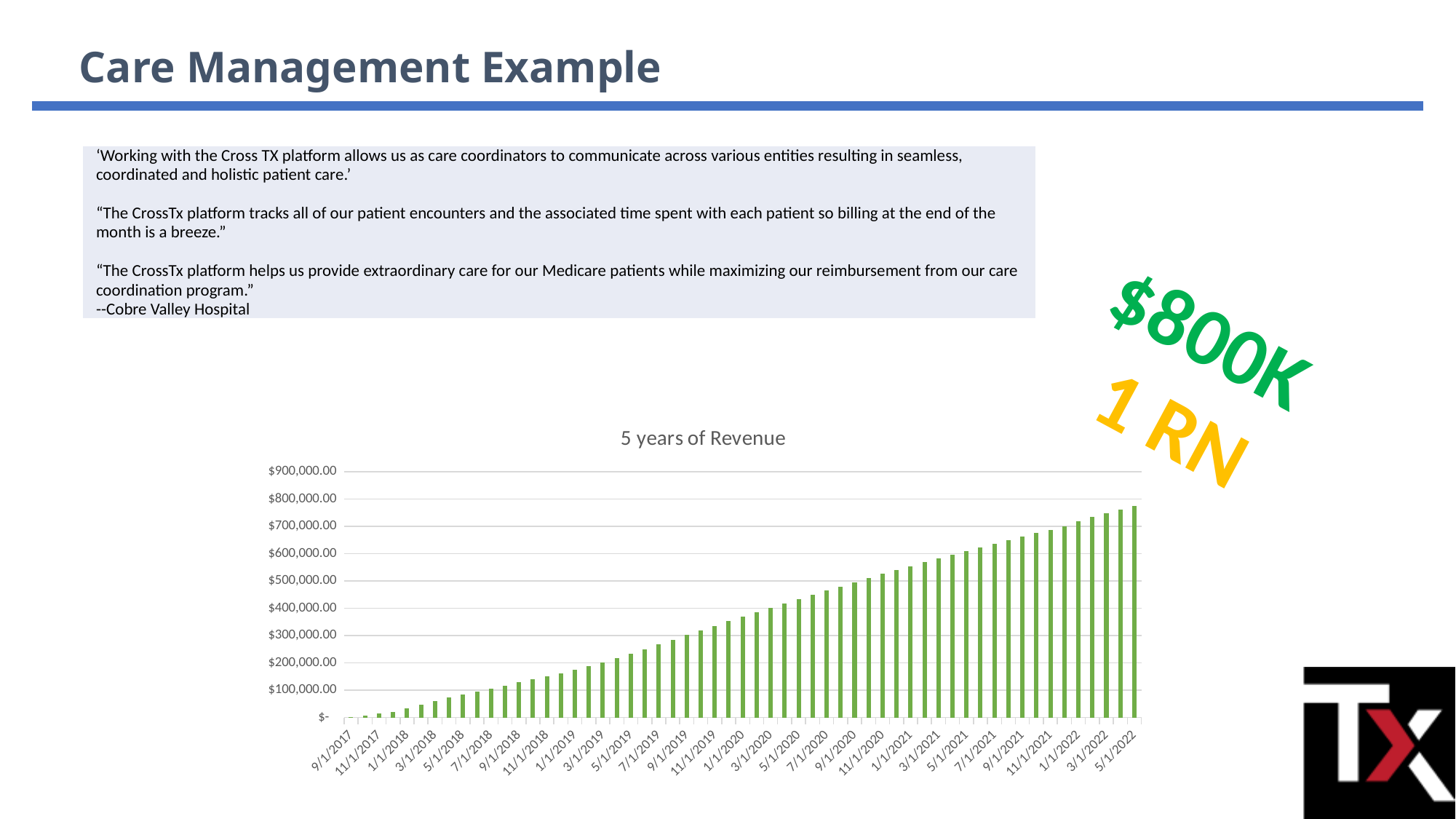
What kind of chart is shown on the slide? Bar chart Is the value for 5/1/2018 greater or less than $100,000.00? less What is the highest value shown on the y axis? $900,000.00 Is the value for 1/1/2020 greater or less than $400,000.00? less Is the value for 1/1/2021 greater or less than $500,000.00? greater Which is larger, the value for 1/1/2021 or the value for 1/1/2019? 1/1/2021 What is the title of the chart? 5 years of Revenue Which date has the highest revenue bar? 5/1/2022 Which date has the lowest revenue bar? 9/1/2017 Do the revenue values rise or fall from left to right along the x axis? Rise